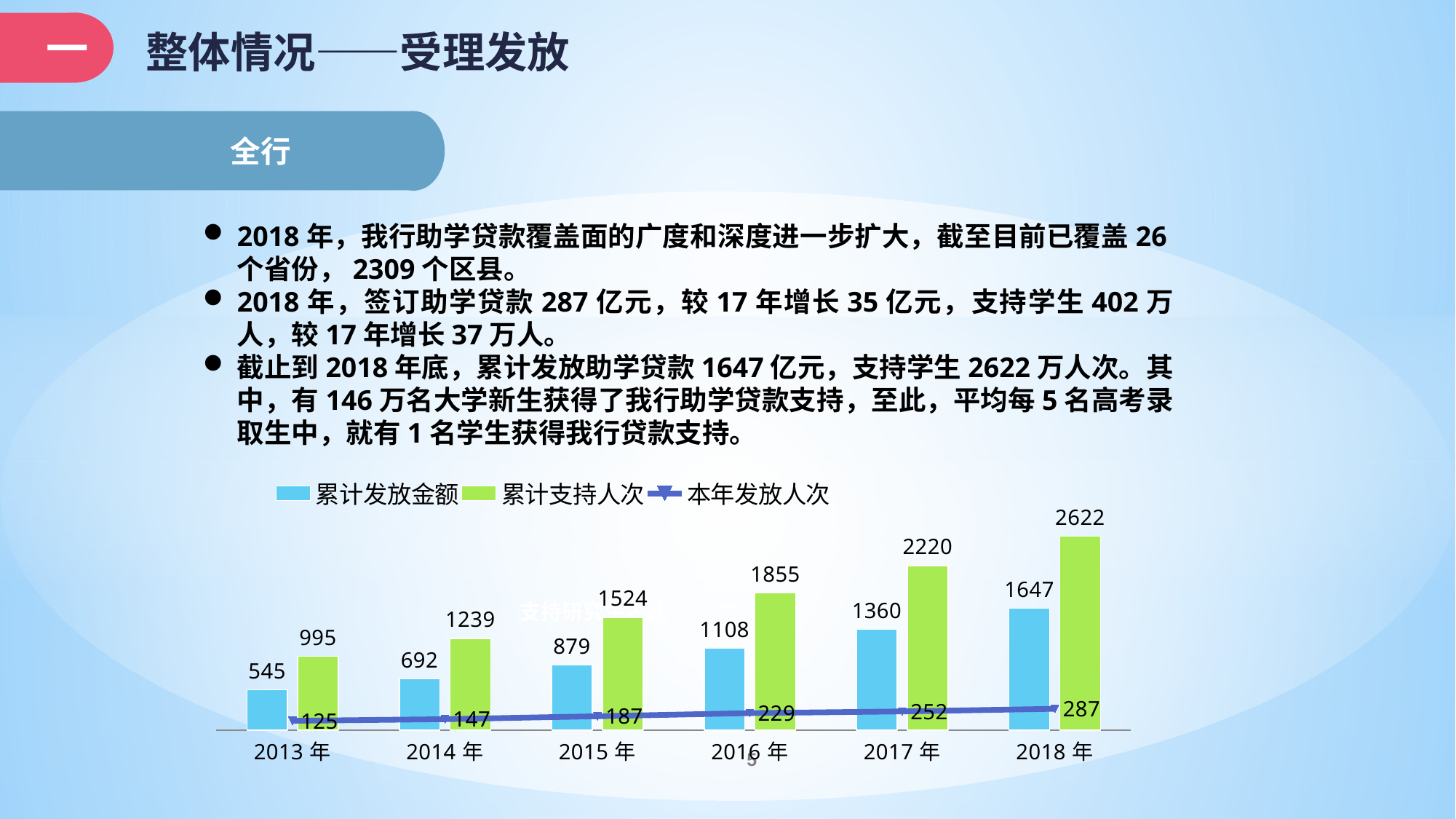
Which year has the highest value of 累计支持人次? 2018 年 What is the difference between the 累计支持人次 values for 2018 年 and 2017 年? 402 What kind of chart is shown on the slide? Combined bar and line chart What is the value of 本年发放人次 for 2016 年? 229 How many series does the chart legend list? 3 What is the difference between the 本年发放人次 values for 2018 年 and 2017 年? 35 Does the 本年发放人次 line rise or fall from 2013 年 to 2018 年? Rise How many years are shown on the x axis of the chart? 6 Which year has the lowest value of 累计发放金额? 2013 年 Which is larger: 累计发放金额 for 2016 年 or 累计支持人次 for 2013 年? 累计发放金额 for 2016 年 What is the value of 累计发放金额 for 2018 年? 1647 What is the value of 累计支持人次 for 2015 年? 1524